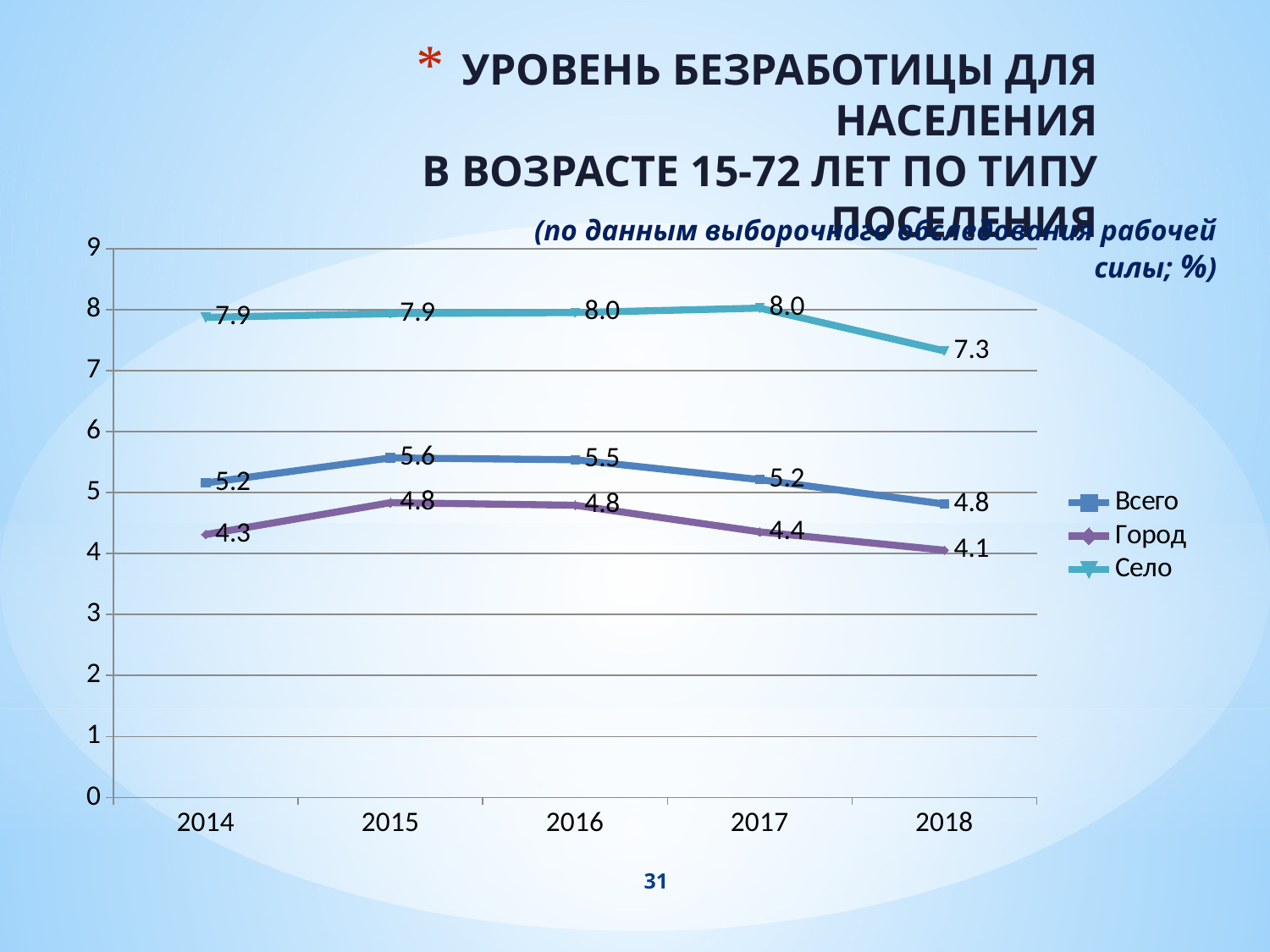
What is the difference between the Всего values in 2015 and 2018? 0.8 Which is larger in 2017: the value for Всего or the value for Город? Всего Is the value for Село in 2014 greater or less than 7? greater What is the value for Всего in 2015? 5.6 What is the value for Город in 2014? 4.3 In which year is the value for Всего highest? 2015 What kind of chart is shown on the slide? line chart What is the value for Село in 2018? 7.3 How many years are shown on the x axis? 5 What is the difference between the Село and Город values in 2016? 3.2 In which year is the value for Город lowest? 2018 How many series does the legend list? 3